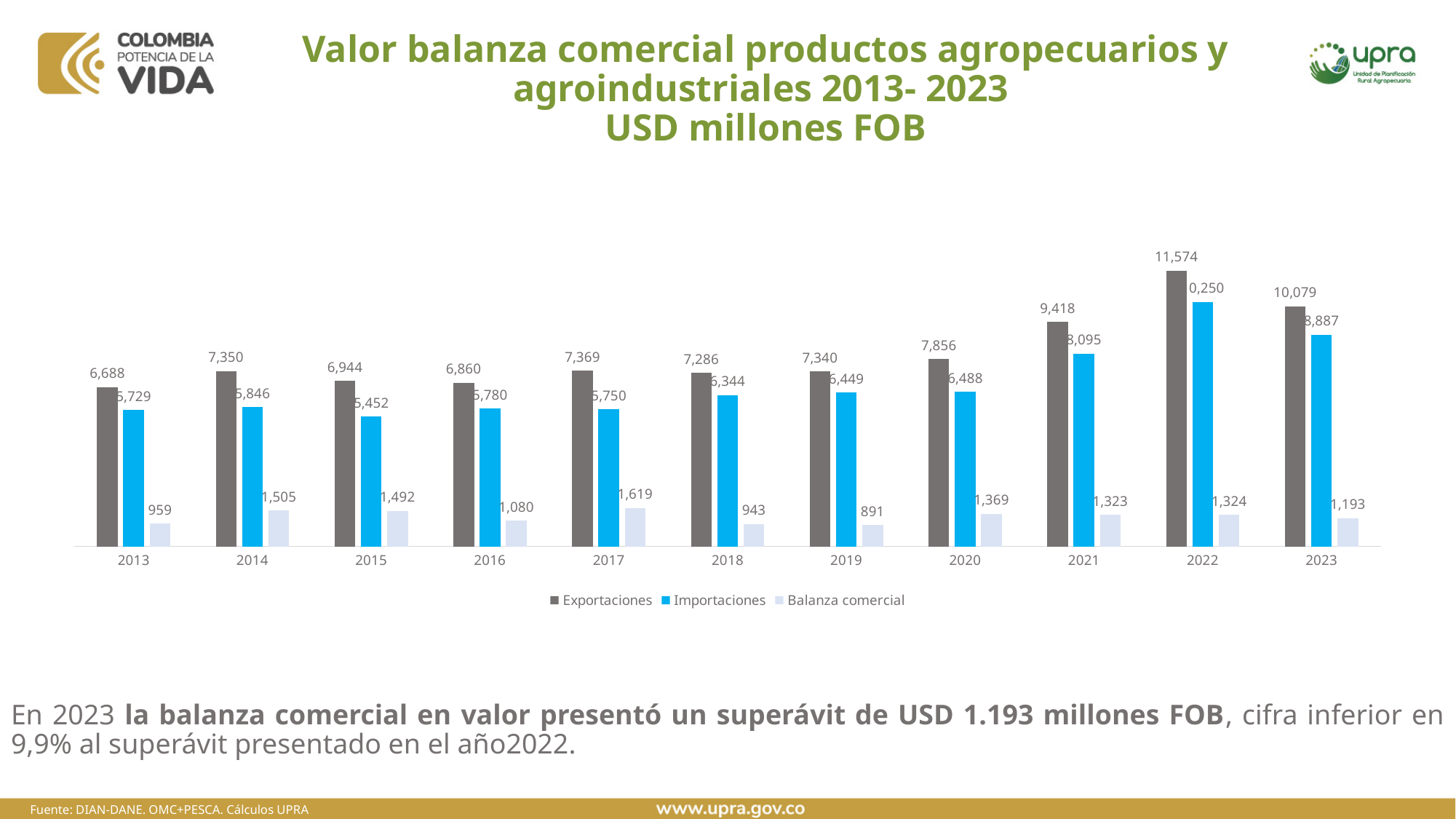
What kind of chart is shown on the slide? Bar chart What is the value of Exportaciones in 2020? 7,856 Which year has higher Exportaciones, 2014 or 2015? 2014 What is the value of Balanza comercial in 2013? 959 In which year is Balanza comercial highest? 2017 How many years are shown on the x axis? 11 What is the difference between Exportaciones in 2022 and in 2023? 1,495 What is the value of Exportaciones in 2022? 11,574 What is the value of Balanza comercial in 2017? 1,619 In which year is Balanza comercial lowest? 2019 In which year is Exportaciones highest? 2022 How many series does the legend list? 3